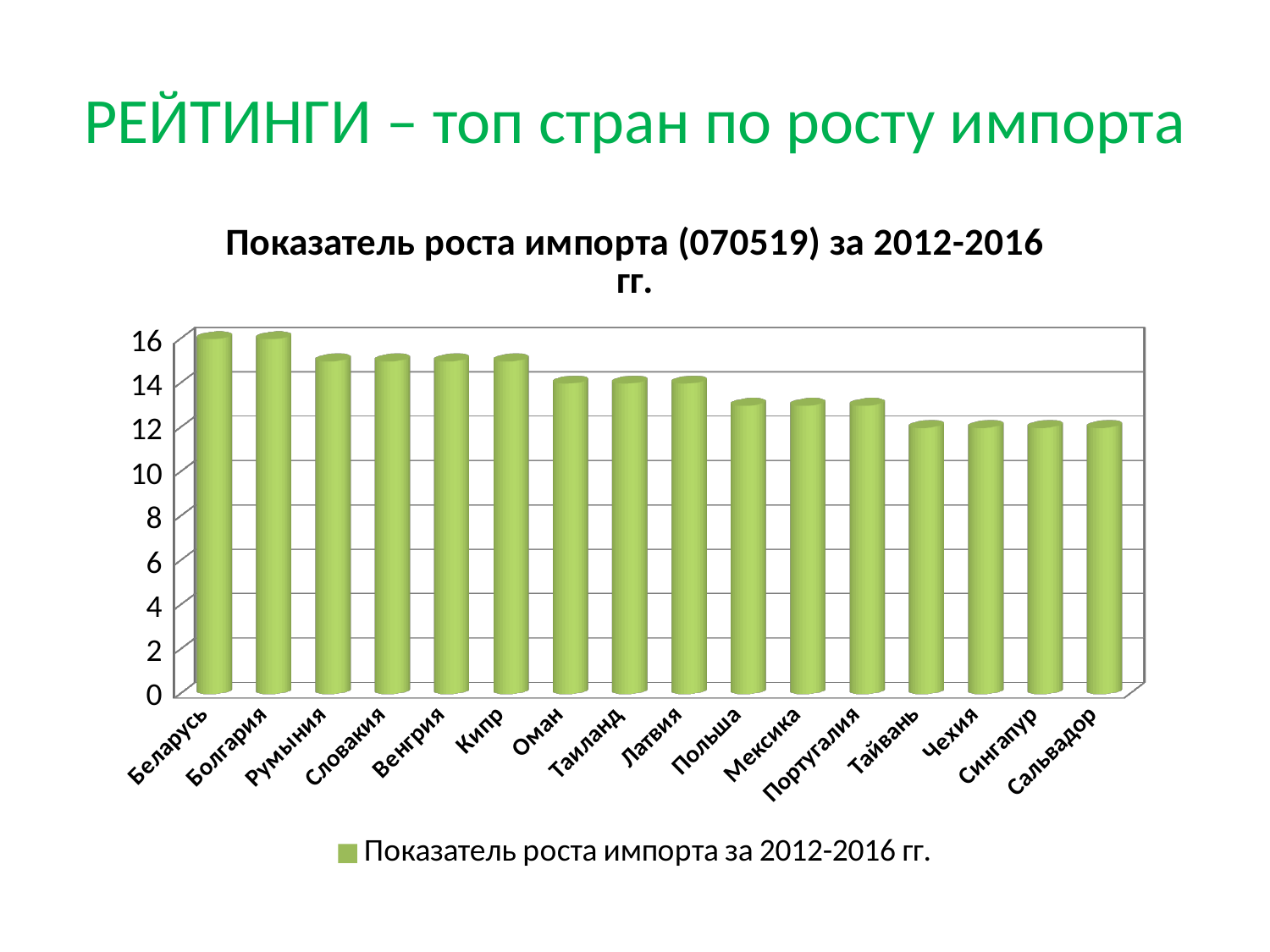
Do the values rise or fall moving from left to right along the x axis? fall Is the value for Сальвадор greater or less than 14? less How many countries are shown on the x axis of the chart? 16 Is the value for Польша greater or less than 14? less Is the value for Оман greater or less than 12? greater How many series does the legend list? 1 Which has the larger value, Беларусь or Сальвадор? Беларусь What kind of chart is shown on the slide? bar chart What is the legend entry of the chart? Показатель роста импорта за 2012-2016 гг. Which has the larger value, Чехия or Кипр? Кипр